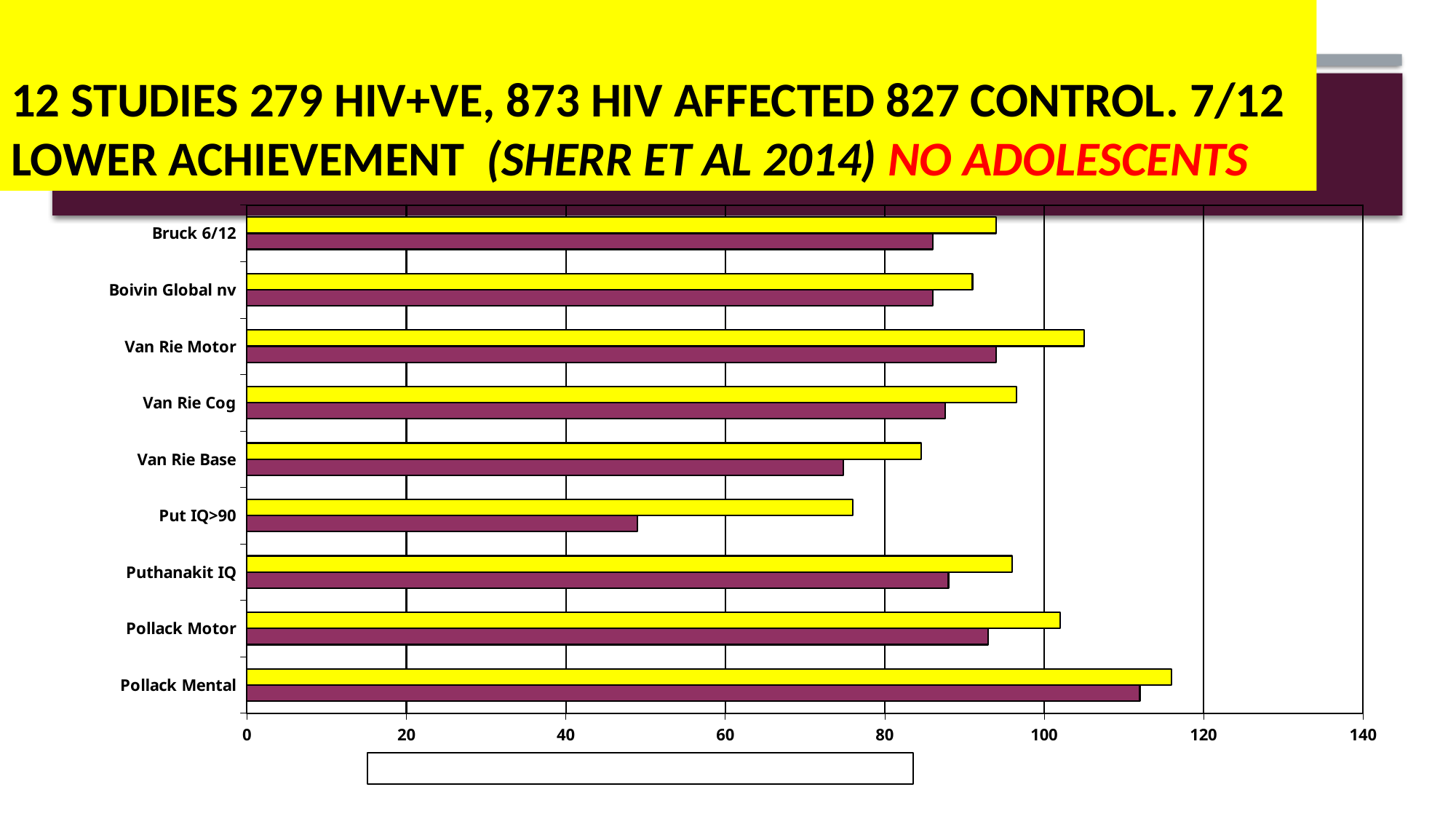
Which is larger, the yellow bar for Van Rie Motor or the yellow bar for Van Rie Base? Van Rie Motor Is the yellow bar for Van Rie Motor greater or less than 100? greater Is the purple bar for Put IQ>90 greater or less than 60? less Is the yellow bar for Pollack Mental greater or less than 100? greater Which category has the shortest purple bar? Put IQ>90 Which category has the shortest yellow bar? Put IQ>90 For Put IQ>90, which bar is longer, the yellow bar or the purple bar? yellow bar Which category has the longest yellow bar? Pollack Mental What kind of chart is shown on the slide? bar chart How many categories (studies/measures) are listed on the vertical axis of the chart? 9 How many bars are plotted for each category in the chart? 2